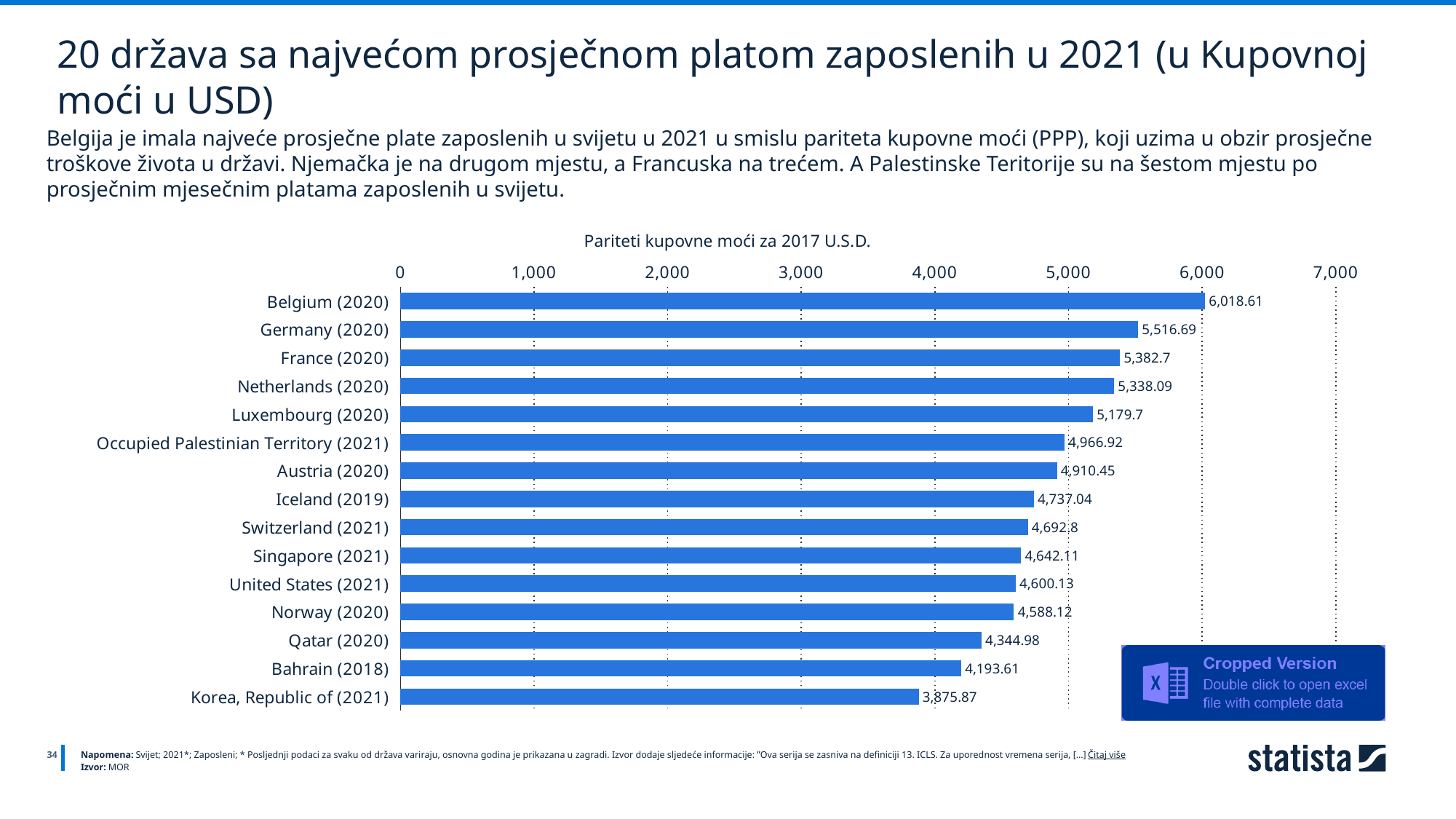
How many categories are shown on the chart? 15 Which is larger, the value for Iceland (2019) or the value for Norway (2020)? Iceland (2019) What is the difference between the values for Belgium (2020) and Germany (2020)? 501.92 Which category has the highest value? Belgium (2020) What is the value for Belgium (2020)? 6,018.61 What is the title of the chart? Pariteti kupovne moći za 2017 U.S.D. Is the value for Luxembourg (2020) greater or less than 5,000? greater What is the difference between the values for Qatar (2020) and Bahrain (2018)? 151.37 What is the value for Korea, Republic of (2021)? 3,875.87 What kind of chart is shown on the slide? bar chart Which category has the lowest value shown on the chart? Korea, Republic of (2021) What is the value for Occupied Palestinian Territory (2021)? 4,966.92